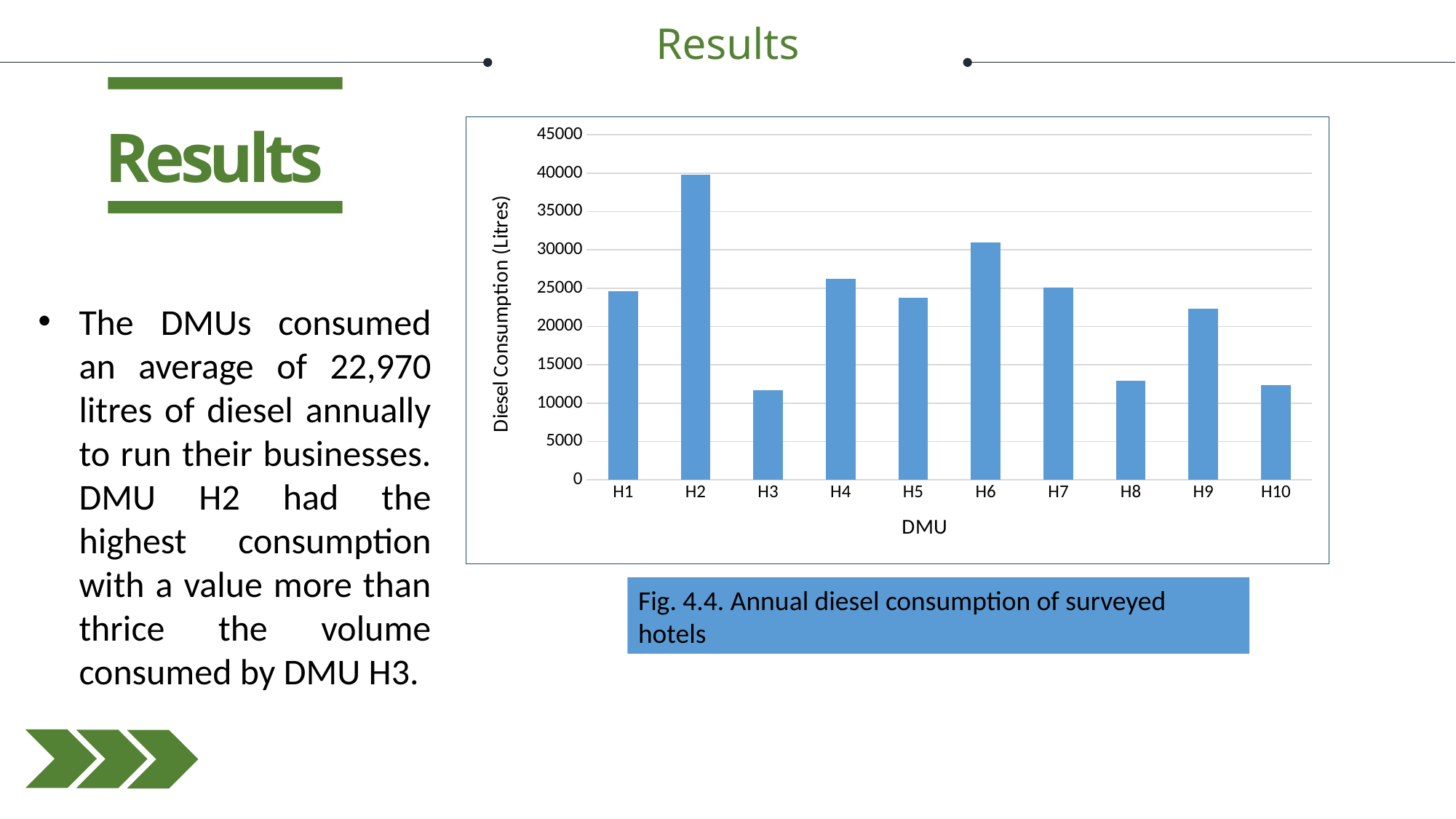
Is the diesel consumption for H3 greater or less than 15000 litres? less What is the label of the y axis of the chart? Diesel Consumption (Litres) Which DMU has the larger diesel consumption, H8 or H9? H9 Is the diesel consumption for H8 greater or less than 15000 litres? less How many DMUs are plotted on the x axis of the chart? 10 Is the diesel consumption for H2 greater or less than 35000 litres? greater Which DMU has the larger diesel consumption, H6 or H4? H6 Which DMU has the highest diesel consumption in the chart? H2 What is the figure caption shown below the chart? Fig. 4.4. Annual diesel consumption of surveyed hotels What kind of chart is shown on the slide? bar chart